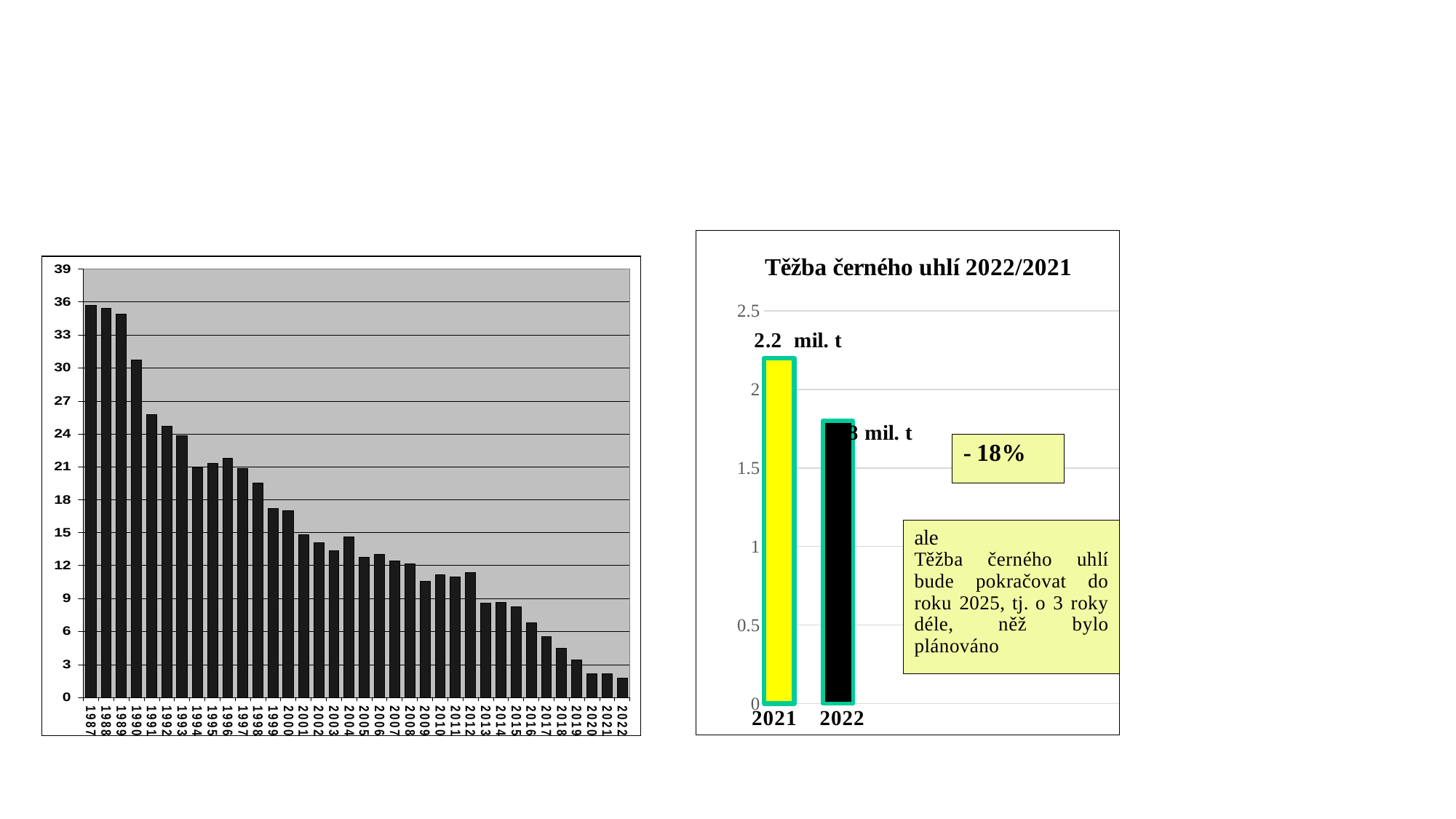
On the chart titled 'Těžba černého uhlí 2022/2021', which year has the larger value, 2021 or 2022? 2021 On the left chart, which year has the lowest bar? 2022 On the chart titled 'Těžba černého uhlí 2022/2021', is the value for 2022 greater or less than 2? less On the left chart, is the value for 2005 greater or less than 15? less On the left chart, how many years are plotted? 36 On the chart titled 'Těžba černého uhlí 2022/2021', what is the value for 2021? 2.2 mil. t On the left chart, do the values generally rise or fall from 1987 to 2022? fall On the left chart, is the value for 1987 greater or less than 33? greater On the left chart, which year has the highest bar? 1987 What kind of chart is the chart titled 'Těžba černého uhlí 2022/2021'? bar chart